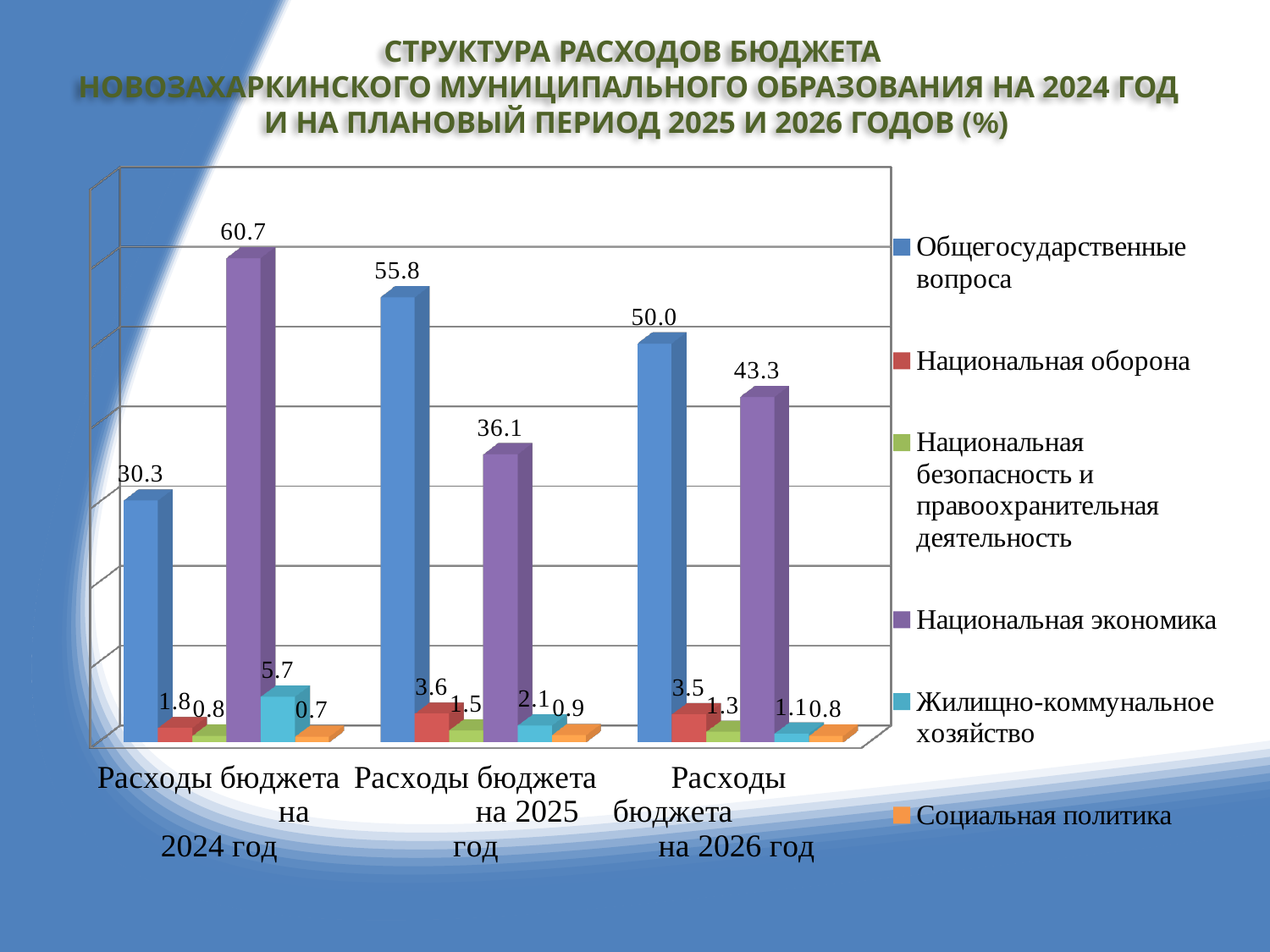
Which is larger in Расходы бюджета на 2026 год: Общегосударственные вопроса or Национальная экономика? Общегосударственные вопроса What is the difference between Национальная экономика and Общегосударственные вопроса in Расходы бюджета на 2024 год? 30.4 Which year has the lowest value for Национальная экономика? Расходы бюджета на 2025 год What is the value for Национальная оборона in Расходы бюджета на 2026 год? 3.5 Which year has the highest value for Общегосударственные вопроса? Расходы бюджета на 2025 год Does the value for Жилищно-коммунальное хозяйство rise or fall from 2024 to 2026? Fall How many series does the legend list? 6 How many year categories are shown on the x axis? 3 What is the value for Национальная экономика in Расходы бюджета на 2024 год? 60.7 What kind of chart is shown on the slide? Bar chart What is the value for Общегосударственные вопроса in Расходы бюджета на 2025 год? 55.8 What is the value for Жилищно-коммунальное хозяйство in Расходы бюджета на 2024 год? 5.7